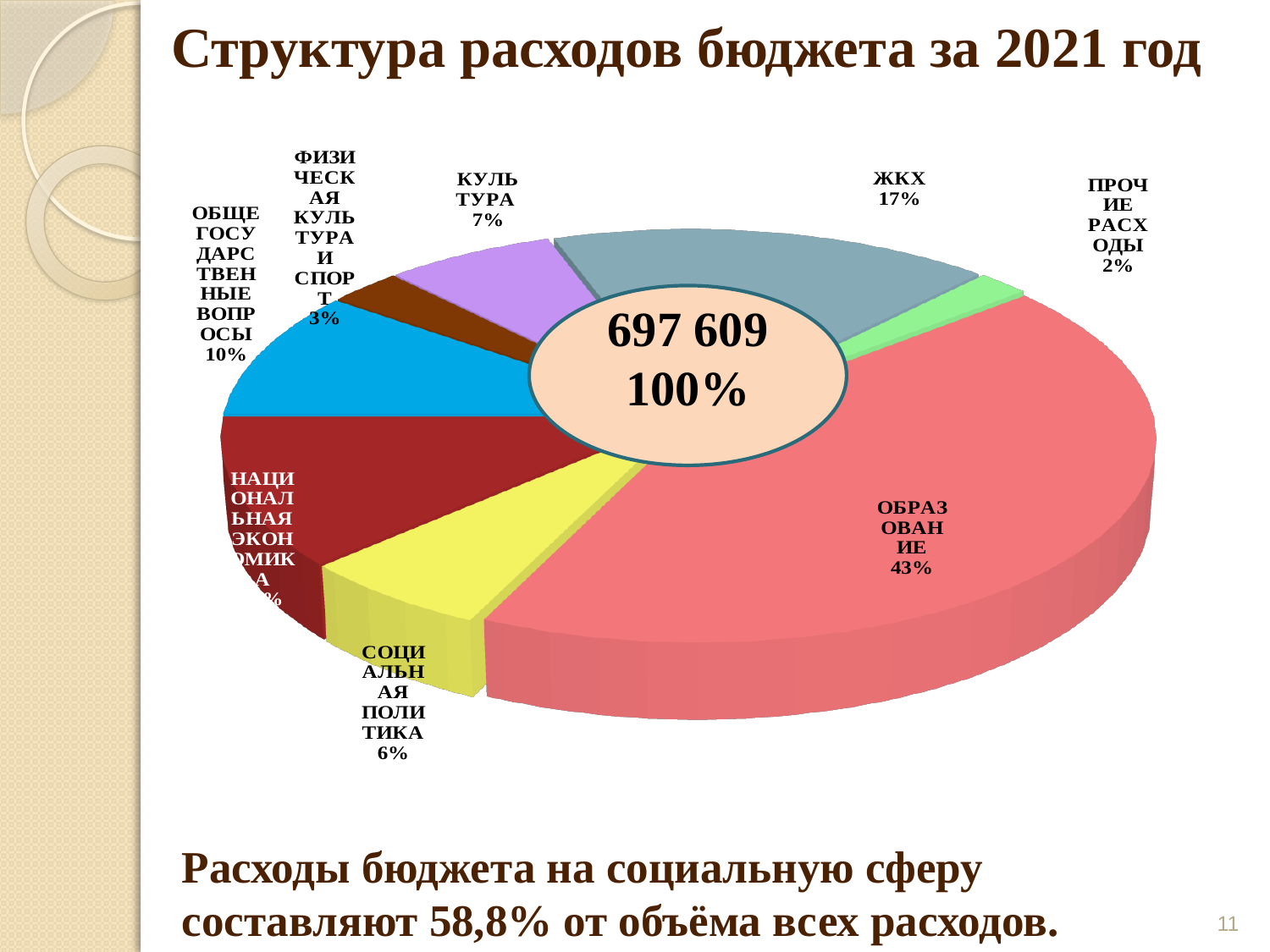
How many slices does the pie chart have? 8 What percentage is shown for КУЛЬТУРА? 7% What kind of chart is shown on the slide? pie chart By how many percentage points does ОБРАЗОВАНИЕ exceed ЖКХ? 26% What share of budget expenditure does ОБРАЗОВАНИЕ account for? 43% Which is larger: the share for ОБЩЕГОСУДАРСТВЕННЫЕ ВОПРОСЫ or for СОЦИАЛЬНАЯ ПОЛИТИКА? ОБЩЕГОСУДАРСТВЕННЫЕ ВОПРОСЫ What percentage is shown for ФИЗИЧЕСКАЯ КУЛЬТУРА И СПОРТ? 3% What is the title of the slide with the pie chart? Структура расходов бюджета за 2021 год Which category has the smallest share of the pie? ПРОЧИЕ РАСХОДЫ Which category has the largest share of the pie? ОБРАЗОВАНИЕ What total amount is shown in the centre of the pie chart? 697 609 What percentage is shown for ЖКХ? 17%